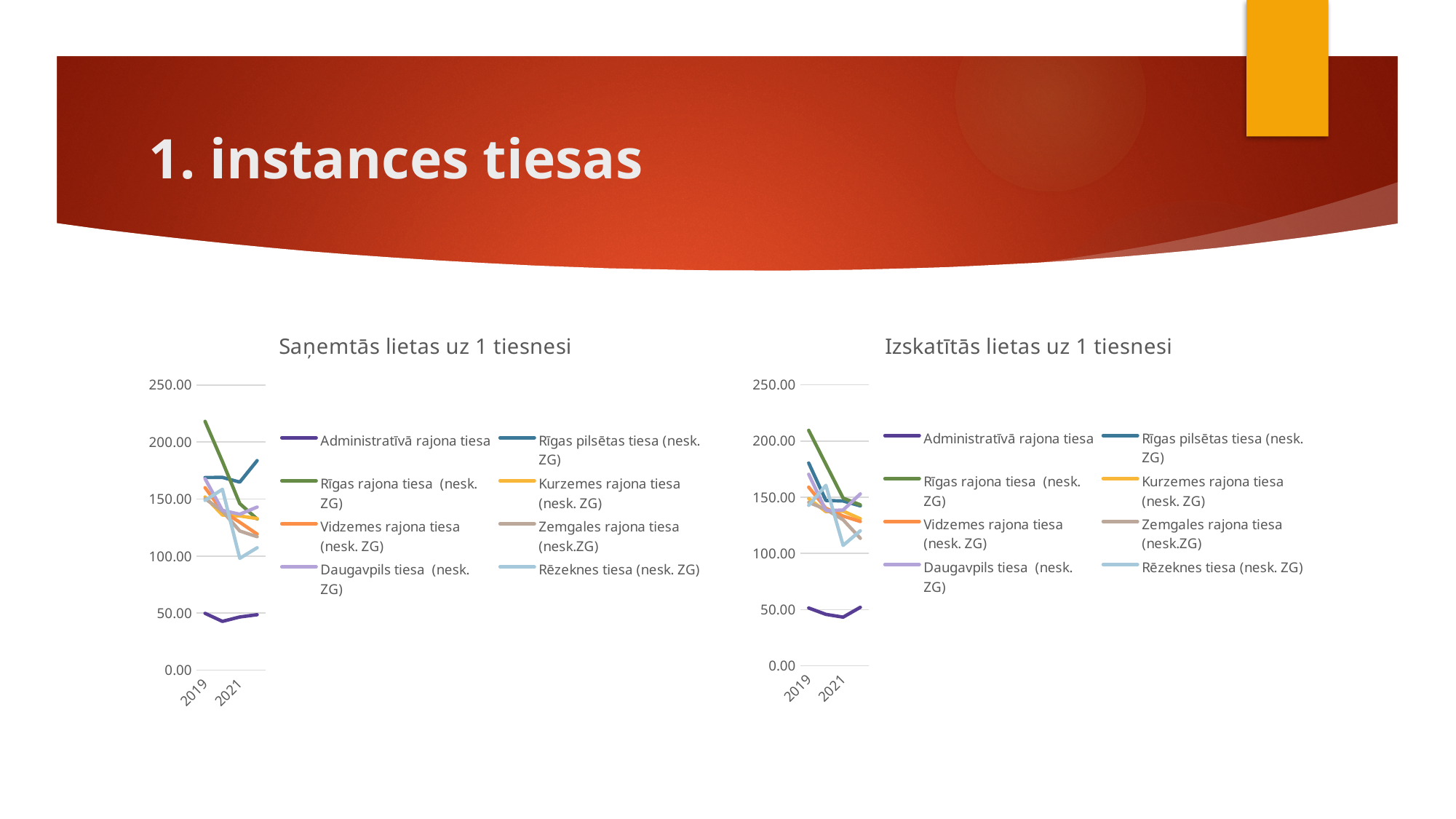
In the "Saņemtās lietas uz 1 tiesnesi" chart, does the line for Rīgas rajona tiesa (nesk. ZG) rise or fall from 2019 to 2021? fall What type of chart is "Saņemtās lietas uz 1 tiesnesi"? line chart In the "Saņemtās lietas uz 1 tiesnesi" chart, is the 2019 value for Rīgas rajona tiesa (nesk. ZG) greater or less than 200? greater In the "Saņemtās lietas uz 1 tiesnesi" chart, is the 2019 value for Administratīvā rajona tiesa greater or less than 100? less What is the title of the chart on the right side of the slide? Izskatītās lietas uz 1 tiesnesi In the "Saņemtās lietas uz 1 tiesnesi" chart, which series is drawn in dark purple? Administratīvā rajona tiesa In the "Izskatītās lietas uz 1 tiesnesi" chart, is the 2019 value for Rīgas rajona tiesa (nesk. ZG) greater or less than 200? greater In the "Izskatītās lietas uz 1 tiesnesi" chart, which is larger in 2019: Rīgas rajona tiesa (nesk. ZG) or Administratīvā rajona tiesa? Rīgas rajona tiesa (nesk. ZG) In the "Saņemtās lietas uz 1 tiesnesi" chart, which series has the highest value in 2019? Rīgas rajona tiesa (nesk. ZG) In the "Izskatītās lietas uz 1 tiesnesi" chart, which series has the lowest value in 2019? Administratīvā rajona tiesa How many series does the legend of the "Saņemtās lietas uz 1 tiesnesi" chart list? 8 How many series does the legend of the "Izskatītās lietas uz 1 tiesnesi" chart list? 8